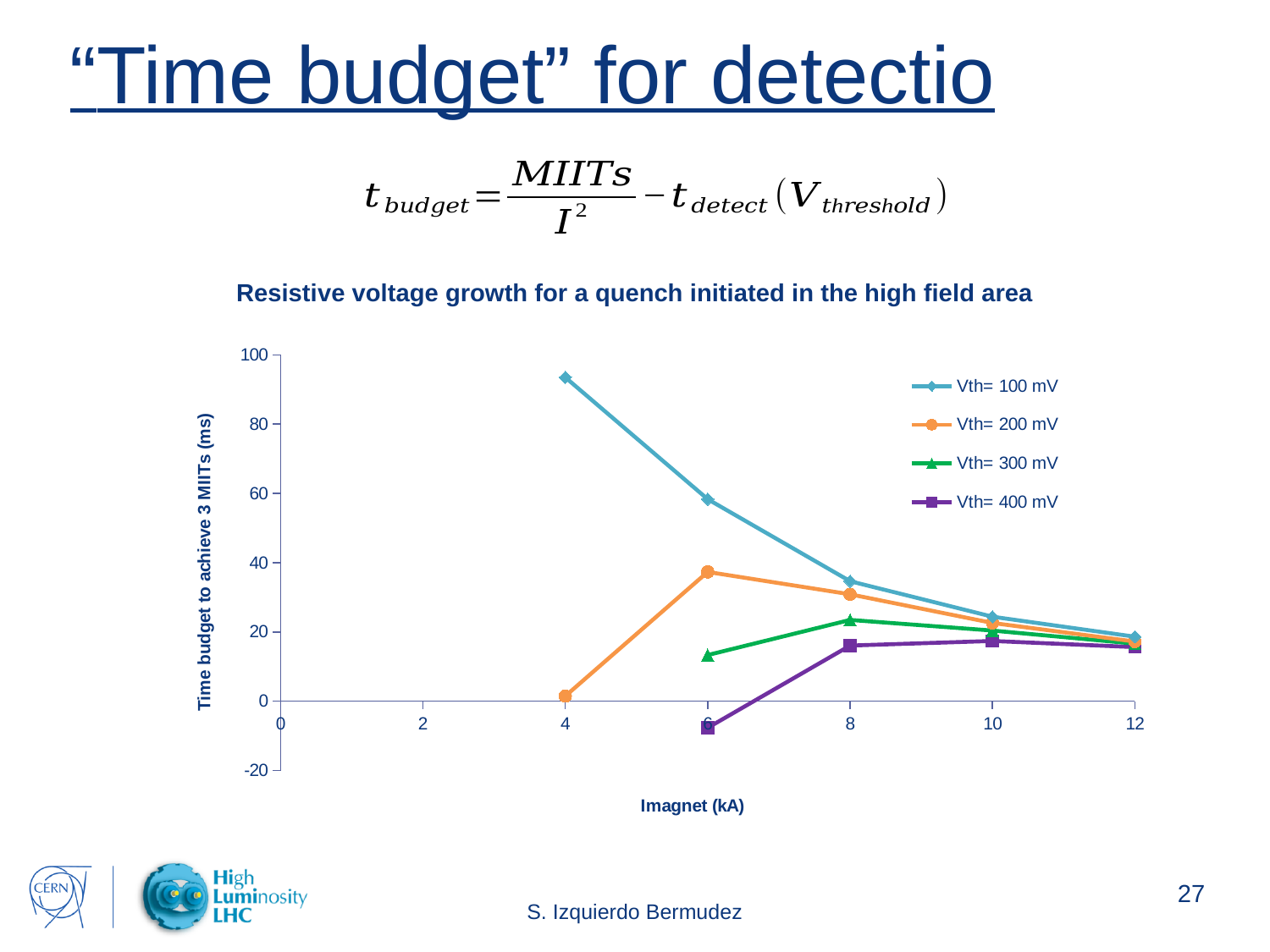
Is the value for Vth= 300 mV at 6 kA greater or less than 20? less Is the value for Vth= 100 mV at 4 kA greater or less than 80? greater What kind of chart is shown on the slide? line chart How many series does the chart legend list? 4 What is the label of the x axis of the chart? Imagnet (kA) Which series has the highest value at 4 kA? Vth= 100 mV What is the title of the chart? Resistive voltage growth for a quench initiated in the high field area Is the value for Vth= 200 mV at 4 kA greater or less than 20? less Does the Vth= 100 mV series rise or fall as the magnet current increases from 4 kA to 12 kA? fall At 6 kA, which is larger: the value for Vth= 100 mV or the value for Vth= 200 mV? Vth= 100 mV